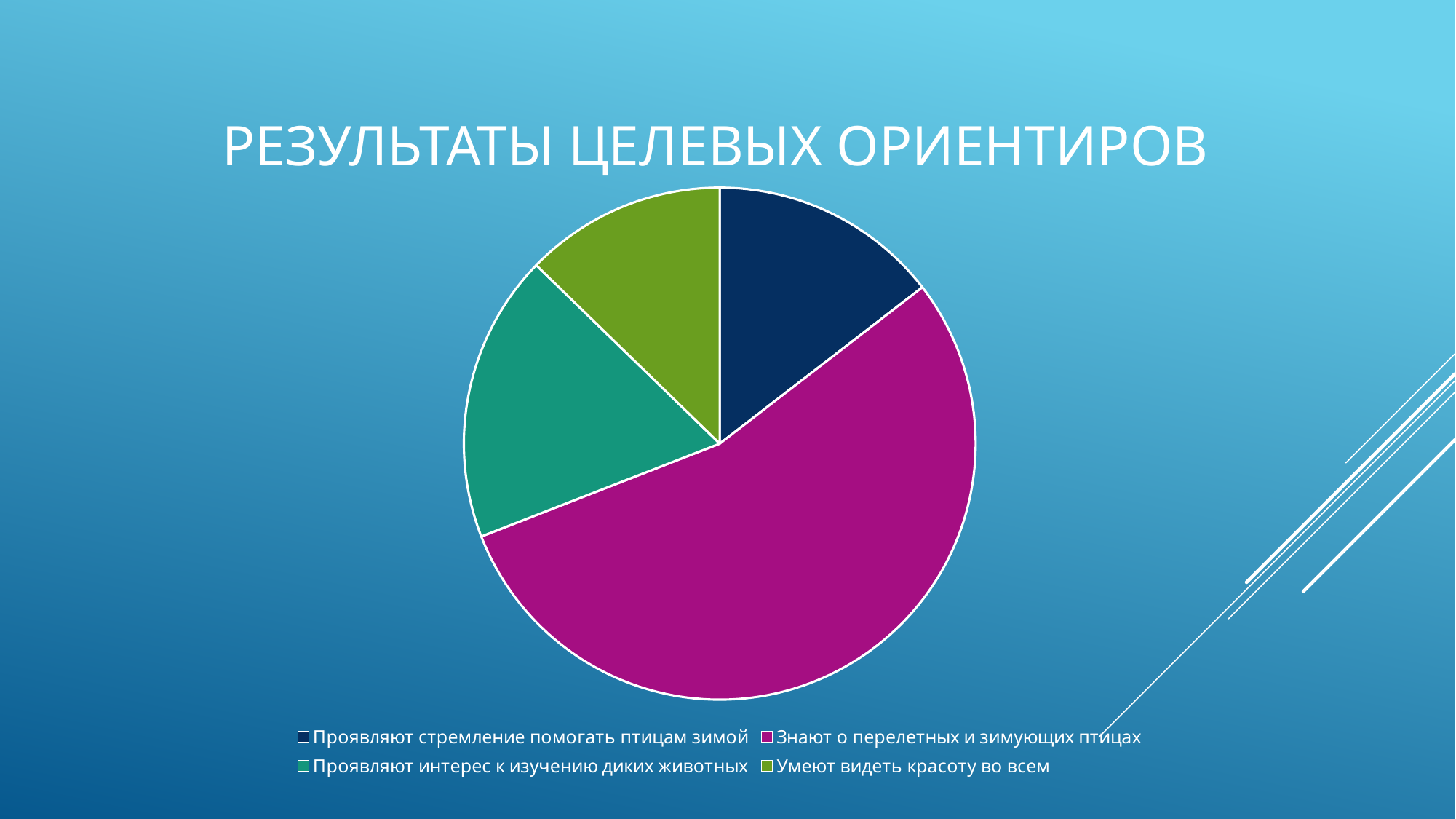
What is the title of the slide containing the pie chart? РЕЗУЛЬТАТЫ ЦЕЛЕВЫХ ОРИЕНТИРОВ Which slice is larger: "Знают о перелетных и зимующих птицах" or "Умеют видеть красоту во всем"? Знают о перелетных и зимующих птицах How many entries does the legend of the pie chart list? 4 Which category has the largest slice of the pie chart? Знают о перелетных и зимующих птицах Which category is shown in magenta in the pie chart? Знают о перелетных и зимующих птицах How many slices does the pie chart have? 4 Which slice is larger: "Знают о перелетных и зимующих птицах" or "Проявляют стремление помогать птицам зимой"? Знают о перелетных и зимующих птицах Which slice is larger: "Знают о перелетных и зимующих птицах" or "Проявляют интерес к изучению диких животных"? Знают о перелетных и зимующих птицах What kind of chart is shown on the slide? Pie chart